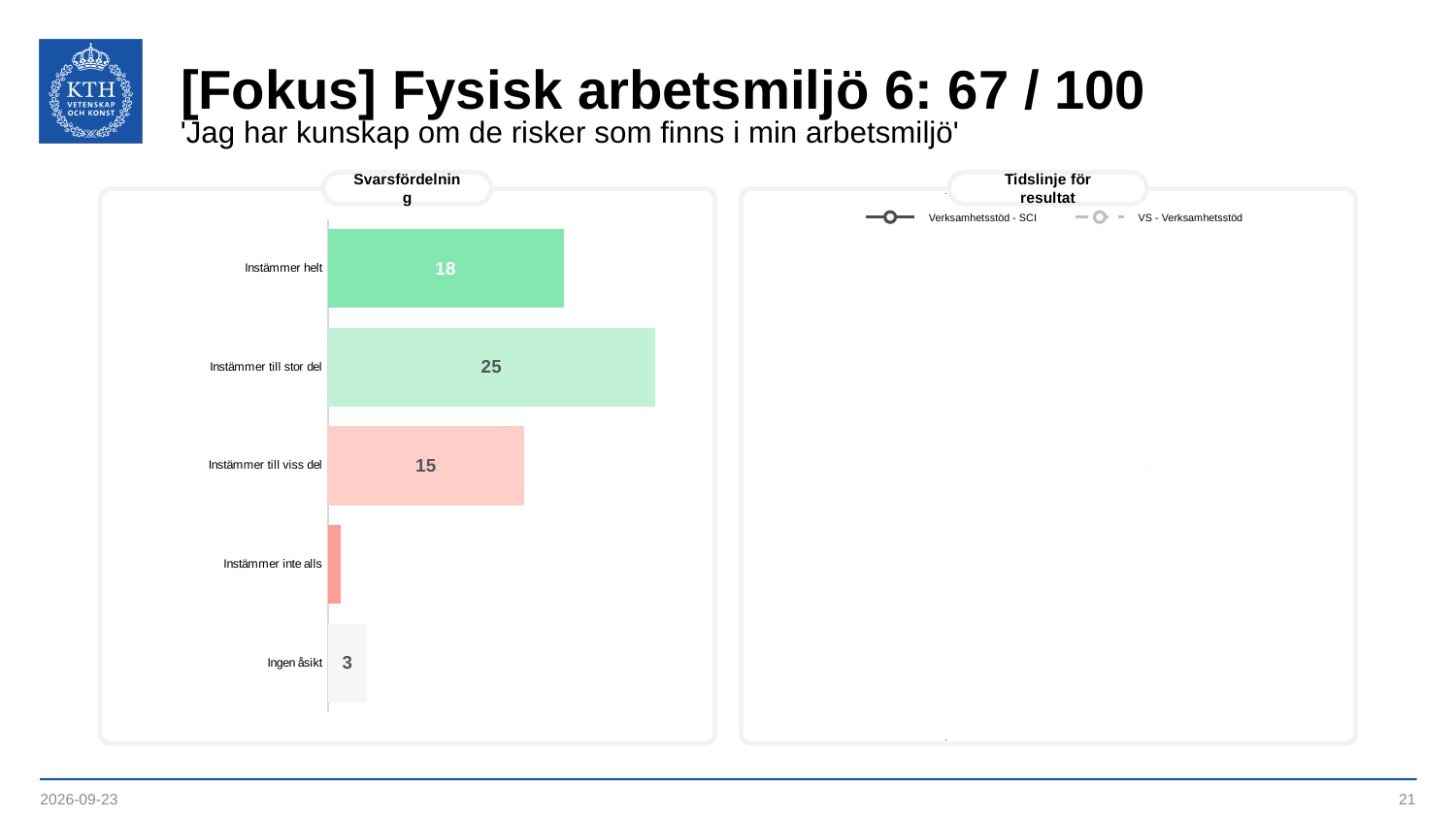
How many categories are shown in the Svarsfördelning chart? 5 In the Svarsfördelning chart, what is the value for 'Ingen åsikt'? 3 In the Svarsfördelning chart, which is larger: 'Instämmer helt' or 'Instämmer till viss del'? Instämmer helt In the Svarsfördelning chart, what is the value for 'Instämmer helt'? 18 In the Svarsfördelning chart, what is the value for 'Instämmer till stor del'? 25 In the Svarsfördelning chart, which category has the highest value? Instämmer till stor del How many series does the legend of the 'Tidslinje för resultat' chart list? 2 In the Svarsfördelning chart, what is the value for 'Instämmer till viss del'? 15 In the Svarsfördelning chart, what is the difference between 'Instämmer till stor del' and 'Instämmer helt'? 7 In the Svarsfördelning chart, which category has the lowest value? Instämmer inte alls What kind of chart is the Svarsfördelning chart? bar chart In the Svarsfördelning chart, what is the difference between 'Instämmer till viss del' and 'Ingen åsikt'? 12